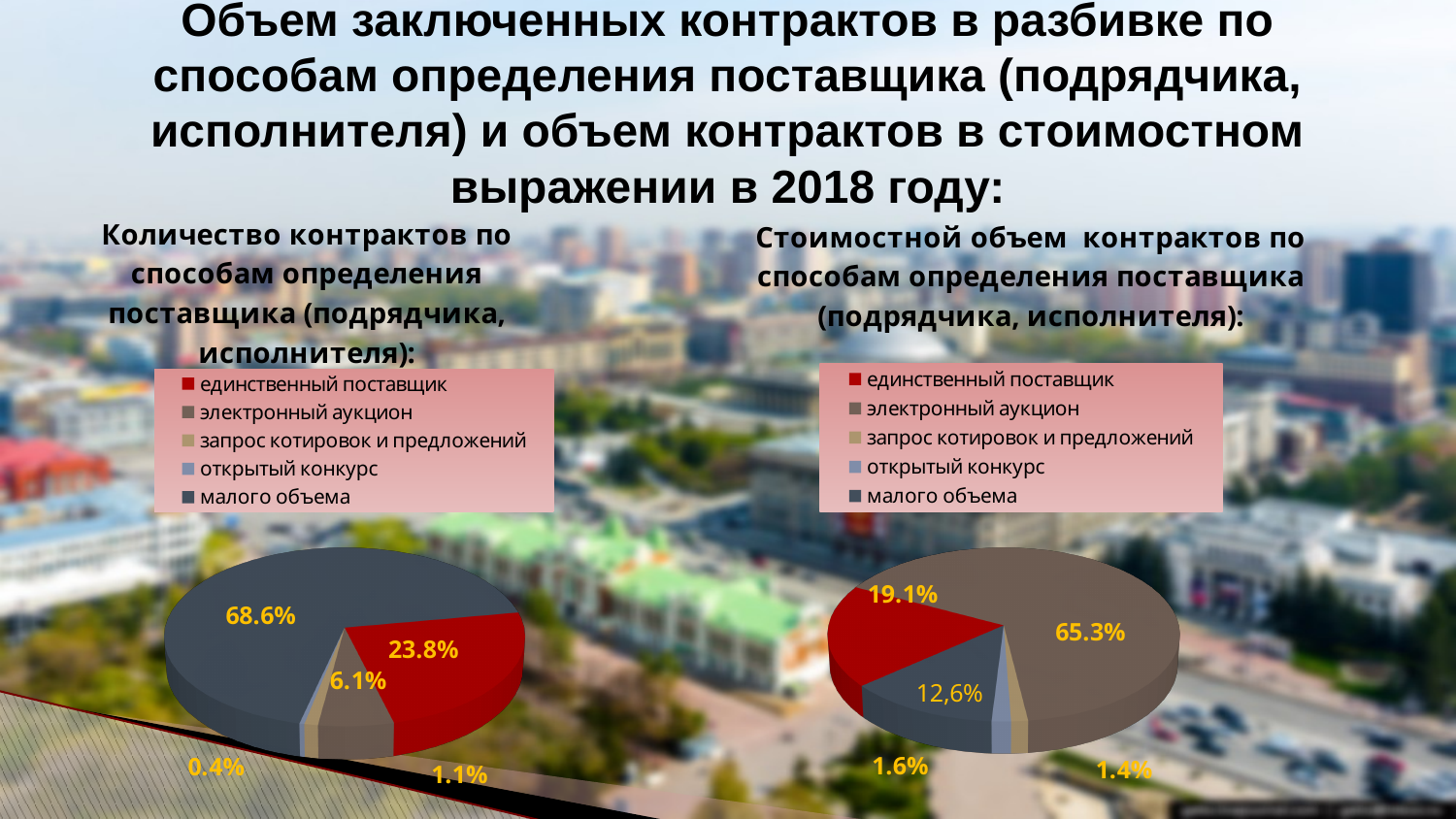
In the left pie chart (Количество контрактов), which category has the largest share? малого объема What type of chart is used on this slide? Pie chart In the right pie chart (Стоимостной объем контрактов), what share is shown for единственный поставщик? 19.1% In the left pie chart (Количество контрактов), what share is shown for малого объема? 68.6% In the right pie chart (Стоимостной объем контрактов), which category has the largest share? электронный аукцион In the left pie chart (Количество контрактов), what share is shown for запрос котировок и предложений? 1.1% In the left pie chart (Количество контрактов), how much larger is the share of малого объема than that of единственный поставщик? 44.8% In the left pie chart (Количество контрактов), what share is shown for единственный поставщик? 23.8% How many categories does the legend of the left pie chart list? 5 In the right pie chart (Стоимостной объем контрактов), what share is shown for электронный аукцион? 65.3% In the right pie chart (Стоимостной объем контрактов), which has the larger share: единственный поставщик or малого объема? единственный поставщик In the right pie chart (Стоимостной объем контрактов), what share is shown for малого объема? 12,6%